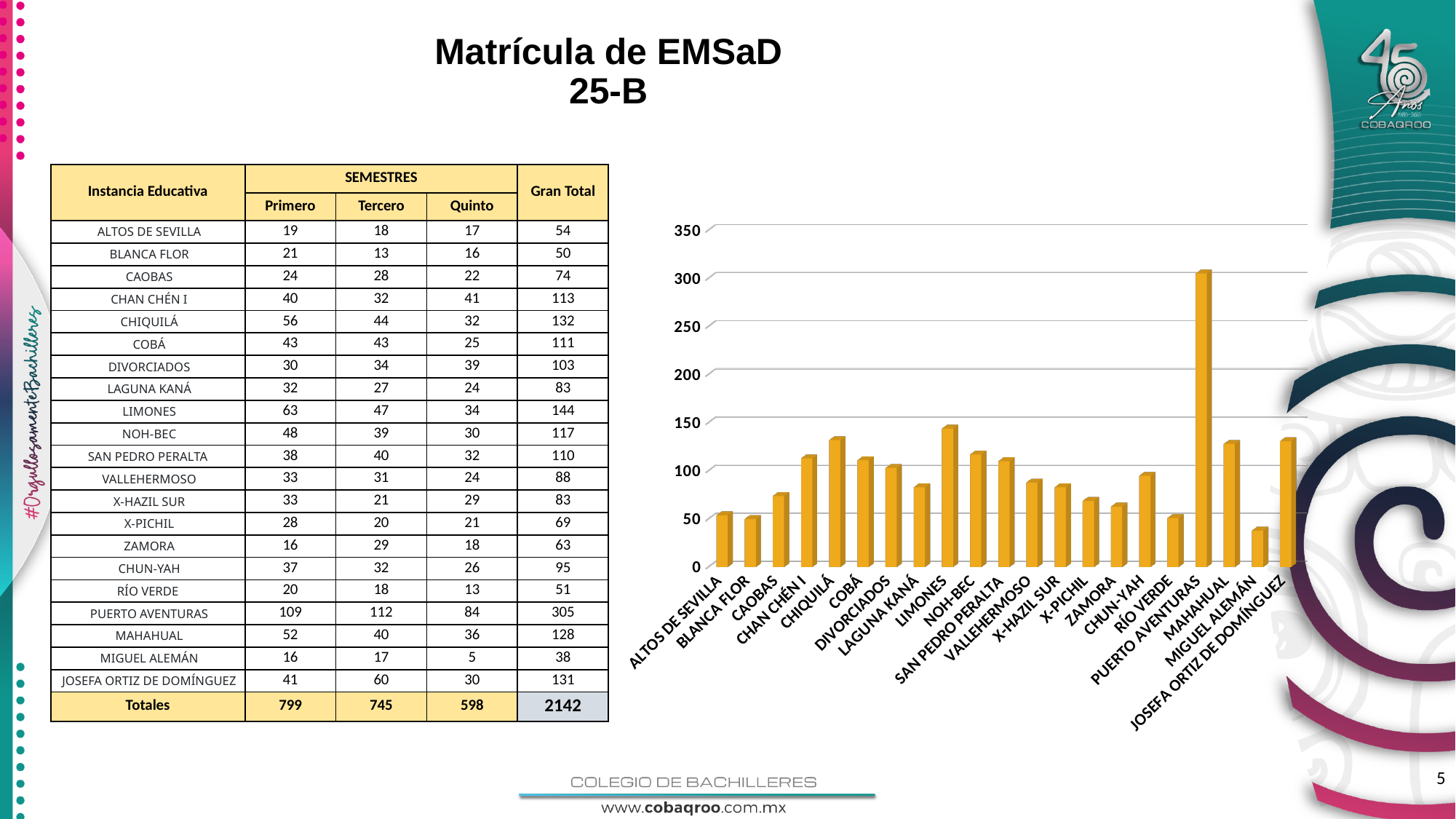
What is the highest value shown on the chart's vertical axis? 350 Which bar is taller on the chart, ZAMORA or CHUN-YAH? CHUN-YAH What kind of chart is shown on the slide? bar chart How many categories (instancias educativas) are plotted on the bar chart? 21 Which bar is taller on the chart, CHIQUILÁ or CAOBAS? CHIQUILÁ What is the Gran Total value plotted for LIMONES? 144 Is the bar for MIGUEL ALEMÁN greater or less than 50? less Is the bar for PUERTO AVENTURAS greater or less than 300? greater Is the bar for LIMONES greater or less than 100? greater Which category has the lowest bar on the chart? MIGUEL ALEMÁN What is the difference between the Gran Total of PUERTO AVENTURAS and MAHAHUAL? 177 Which category has the highest bar on the chart? PUERTO AVENTURAS